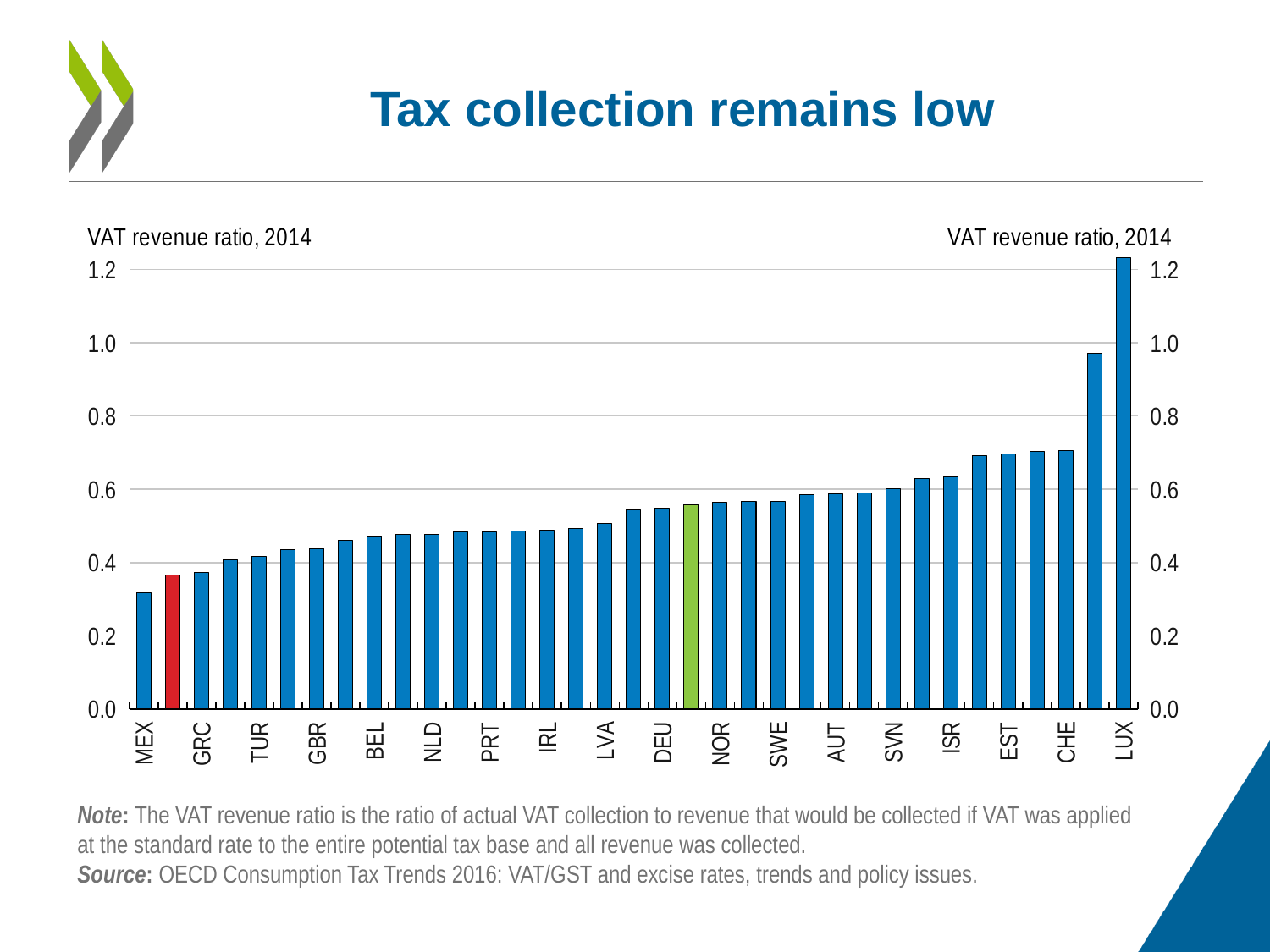
Is the VAT revenue ratio for LUX greater or less than 1.0? greater Is the VAT revenue ratio for CHE greater or less than 0.6? greater Do the VAT revenue ratios rise or fall moving from left to right across the chart? Rise Which country has the lowest VAT revenue ratio in the chart? MEX Is the VAT revenue ratio for MEX greater or less than 0.4? less Which country has the highest VAT revenue ratio in the chart? LUX What is the label shown above the chart's vertical axis? VAT revenue ratio, 2014 Which has a higher VAT revenue ratio, GRC or CHE? CHE What kind of chart is shown on the slide? Bar chart What colour is the bar immediately to the right of MEX? Red